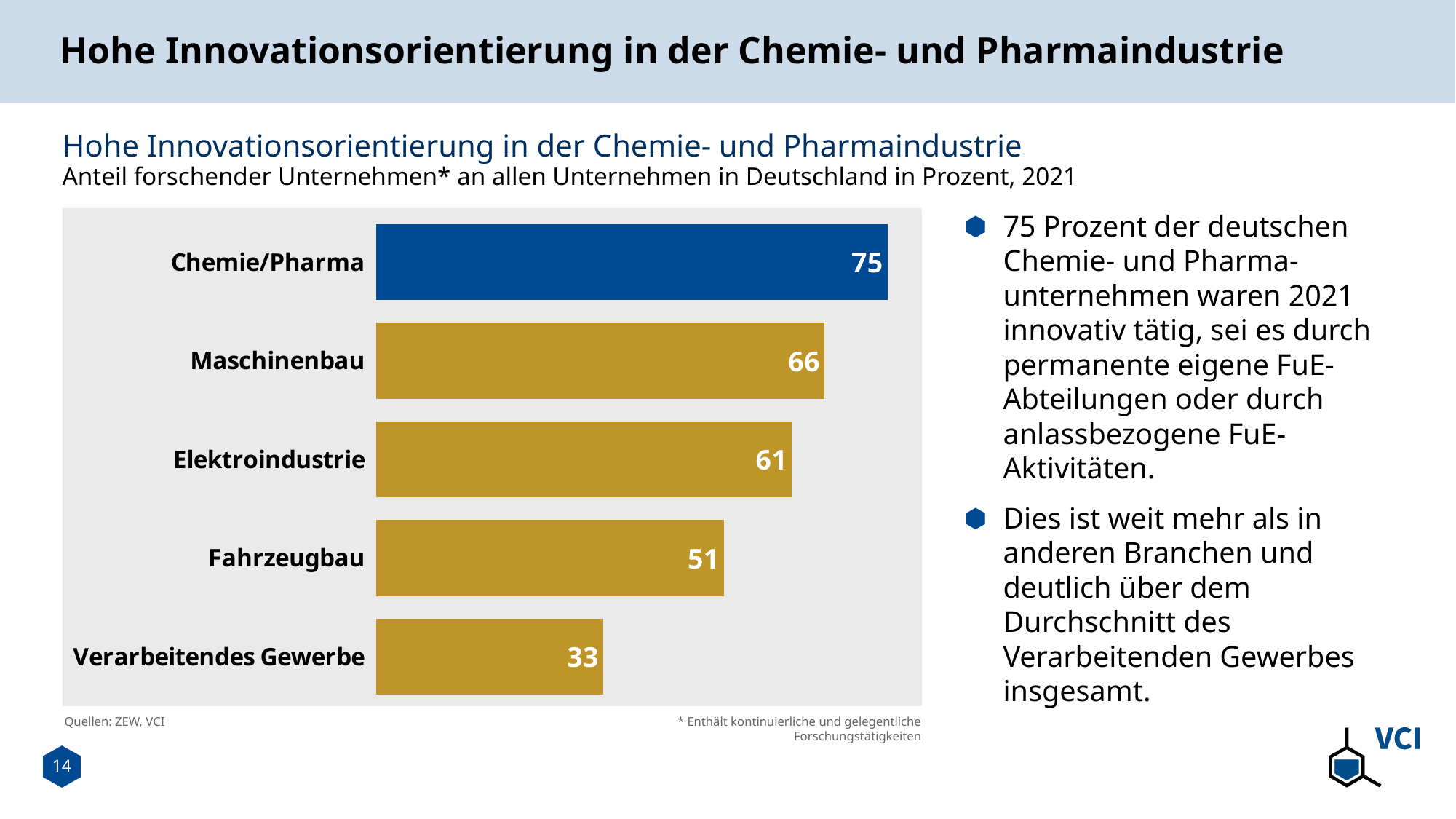
What is the value for Maschinenbau? 66 What is the difference between the values for Maschinenbau and Elektroindustrie? 5 Which is larger, the value for Elektroindustrie or the value for Fahrzeugbau? Elektroindustrie How many categories are shown in the chart? 5 What is the value for Verarbeitendes Gewerbe? 33 What kind of chart is shown on the slide? Bar chart Which bar is shown in a different colour (blue) from the others? Chemie/Pharma What is the value for Fahrzeugbau? 51 What is the difference between the values for Chemie/Pharma and Verarbeitendes Gewerbe? 42 Which category has the highest value? Chemie/Pharma Which category has the lowest value? Verarbeitendes Gewerbe What is the value for Chemie/Pharma? 75